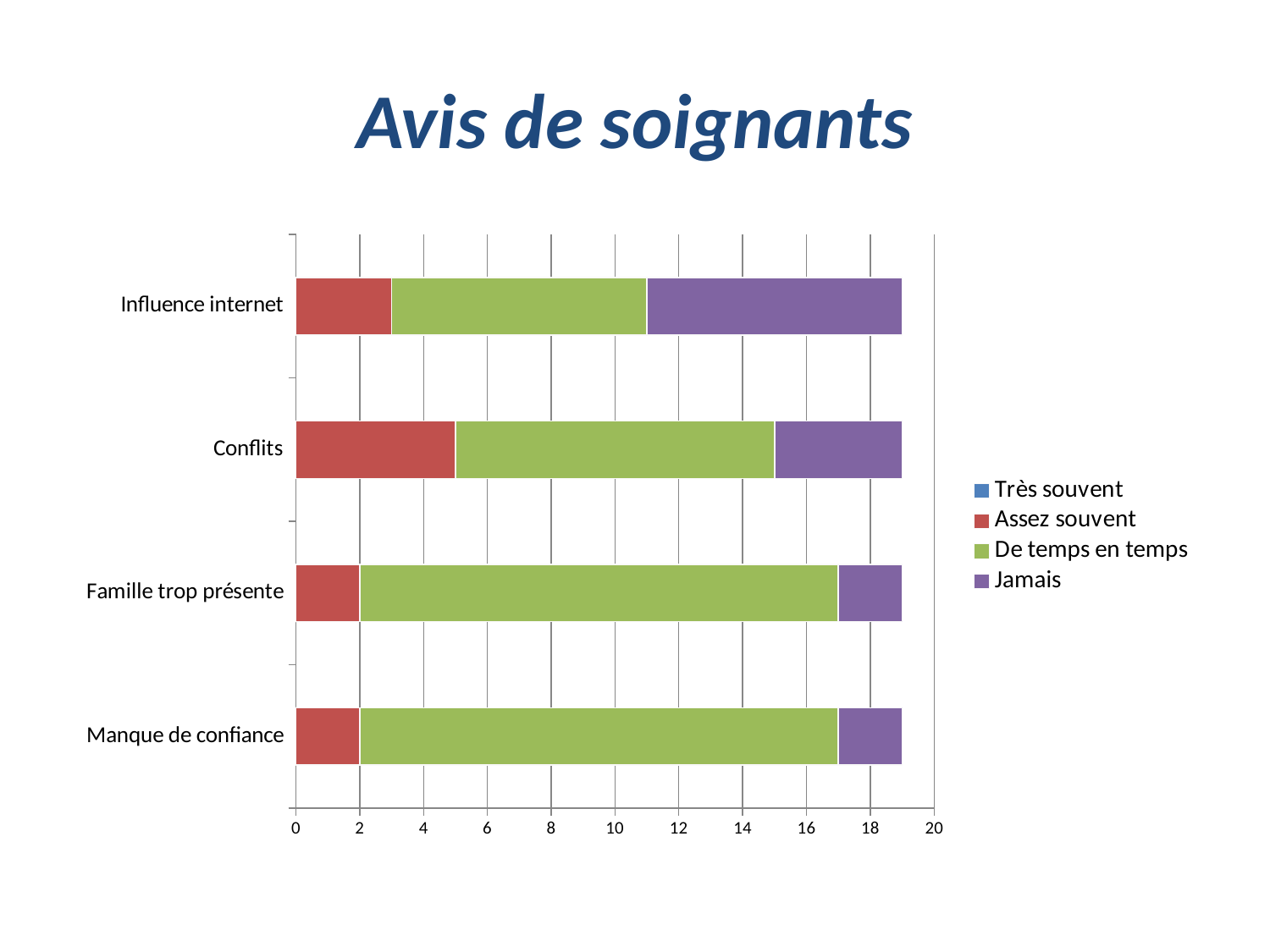
What kind of chart is shown on the slide? Stacked bar chart How many series does the legend list? 4 What is the title of the chart? Avis de soignants What is the value of 'Assez souvent' for 'Famille trop présente'? 2 Is the 'De temps en temps' segment larger for 'Famille trop présente' or for 'Conflits'? Famille trop présente Is the 'Jamais' segment larger for 'Influence internet' or for 'Conflits'? Influence internet What is the value of 'Assez souvent' for 'Manque de confiance'? 2 Which category has the largest 'Assez souvent' segment? Conflits How many categories are shown on the vertical axis of the chart? 4 Which category has the largest 'Jamais' segment? Influence internet Is the total length of the 'Conflits' bar greater or less than 18? greater Is the value of 'Assez souvent' for 'Conflits' greater or less than 4? greater